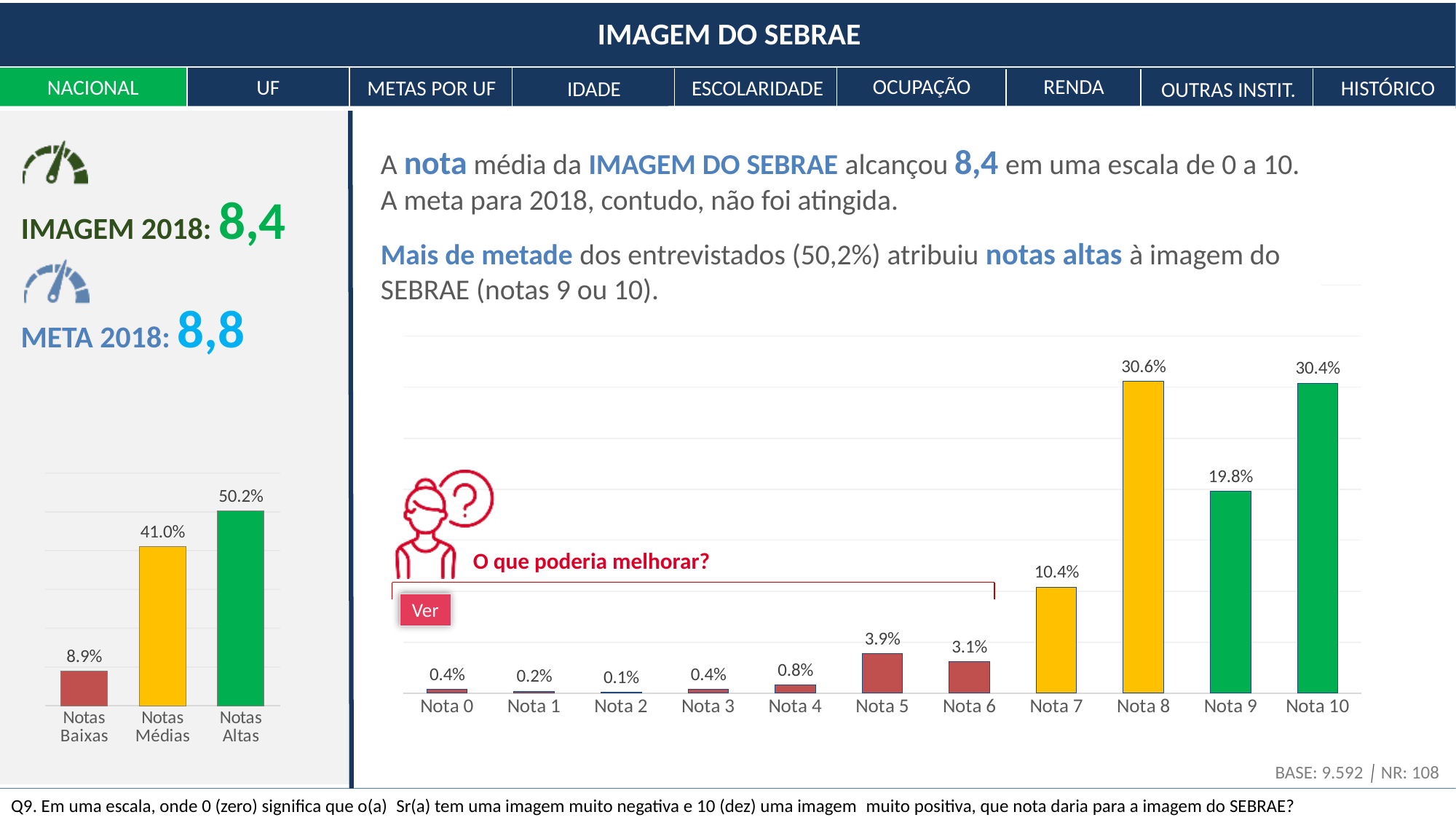
In the chart on the left, what is the difference between the values for Notas Altas and Notas Baixas? 41.3% What kind of chart is the chart on the right? Bar chart How many categories are shown in the chart on the right? 11 In the chart on the right, which category has the lowest value? Nota 2 In the chart on the right, what colour are the bars for Nota 9 and Nota 10? Green In the chart on the left, what is the value for Notas Médias? 41.0% In the chart on the right, what is the value for Nota 8? 30.6% In the chart on the right, which category has the highest value? Nota 8 In the chart on the left, which category has the lowest value? Notas Baixas In the chart on the right, which is larger, the value for Nota 10 or the value for Nota 9? Nota 10 In the chart on the right, what is the value for Nota 5? 3.9% In the chart on the right, what is the difference between the values for Nota 9 and Nota 7? 9.4%